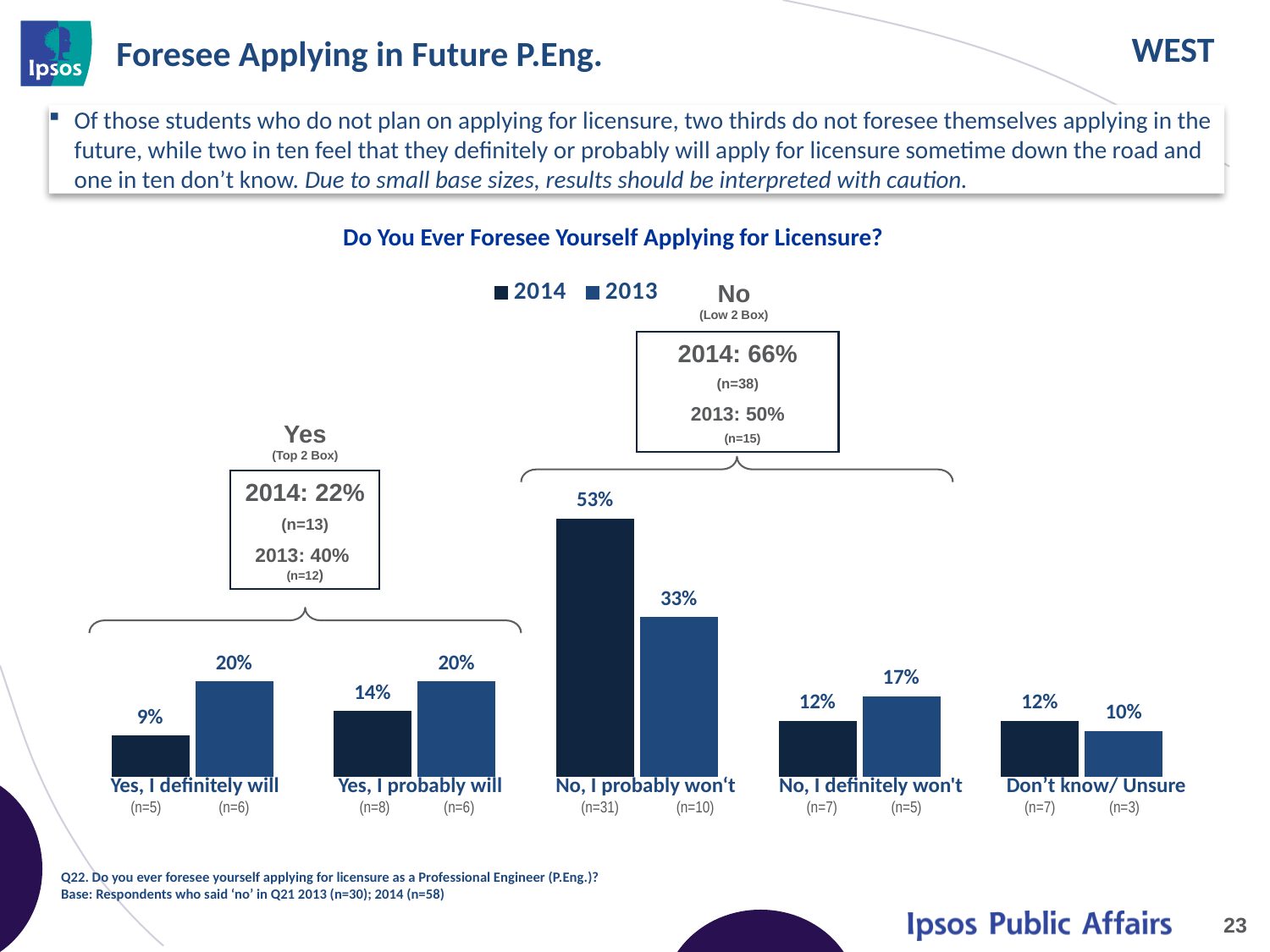
What is the 2013 value for "Don't know/ Unsure"? 10% What is the 2014 value for "Yes, I probably will"? 14% What is the difference between the 2014 and 2013 values for "No, I probably won't"? 20% What is the chart's title? Do You Ever Foresee Yourself Applying for Licensure? Which category has the highest 2014 value? No, I probably won't What is the 2014 value for "No, I probably won't"? 53% How many series does the legend list? 2 How many categories are shown on the x axis? 5 Which category has the lowest 2014 value? Yes, I definitely will Which is larger for "No, I definitely won't": the 2014 value or the 2013 value? 2013 What is the 2013 value for "Yes, I definitely will"? 20% What kind of chart is shown? Bar chart